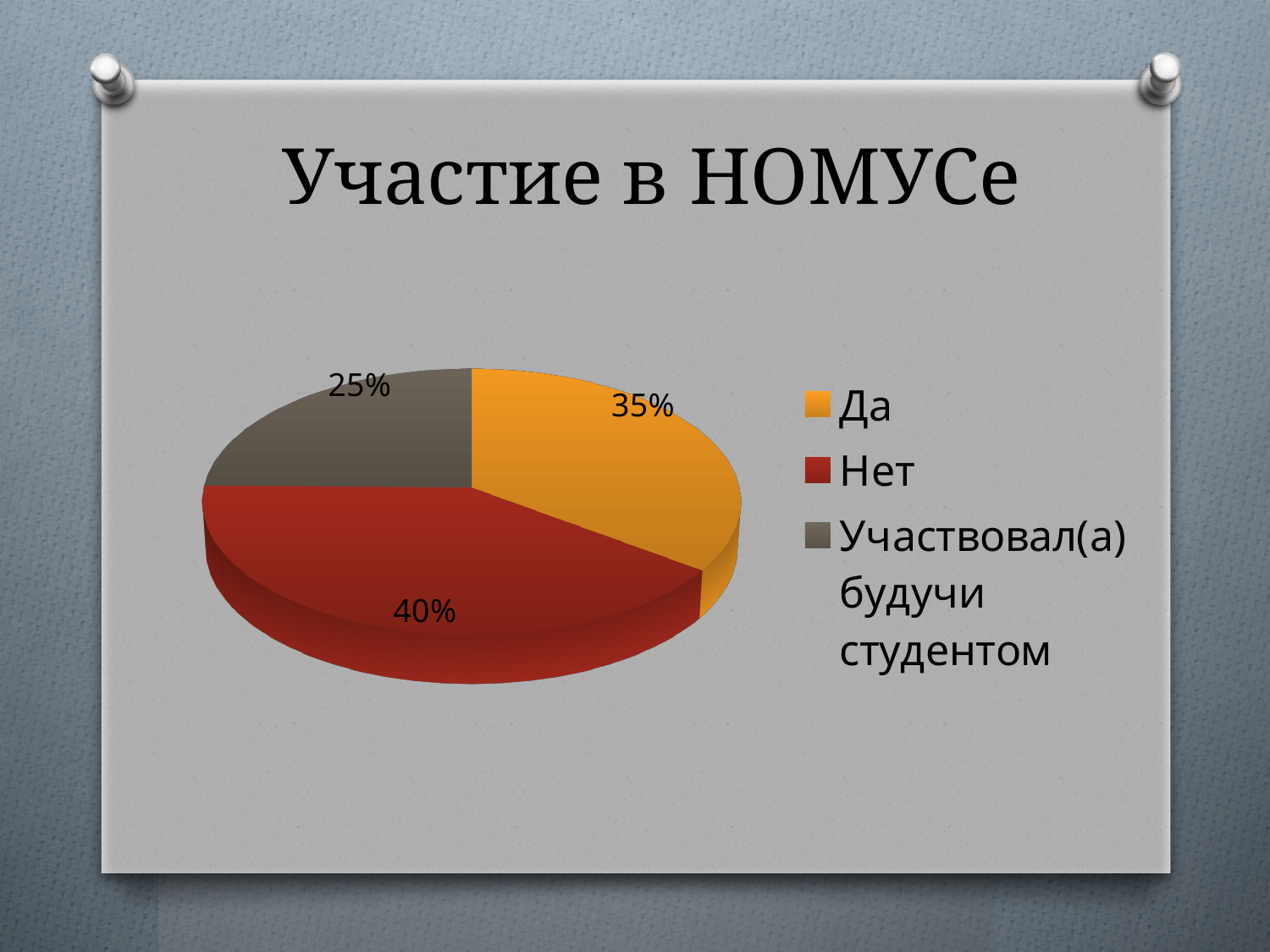
What is the difference in percentage points between the "Нет" slice and the "Да" slice? 5% What colour is the "Нет" slice in the pie chart? Red How many slices does the pie chart have? 3 What type of chart is shown on the slide? Pie chart What is the difference in percentage points between the "Да" slice and the "Участвовал(а) будучи студентом" slice? 10% Which category has the smallest slice of the pie chart? Участвовал(а) будучи студентом What percentage of the pie chart is labelled "Нет"? 40% Which category has the largest slice of the pie chart? Нет What percentage of the pie chart is labelled "Участвовал(а) будучи студентом"? 25% Which slice is larger, "Да" or "Участвовал(а) будучи студентом"? Да What percentage of the pie chart is labelled "Да"? 35% What is the title of the slide? Участие в НОМУСе